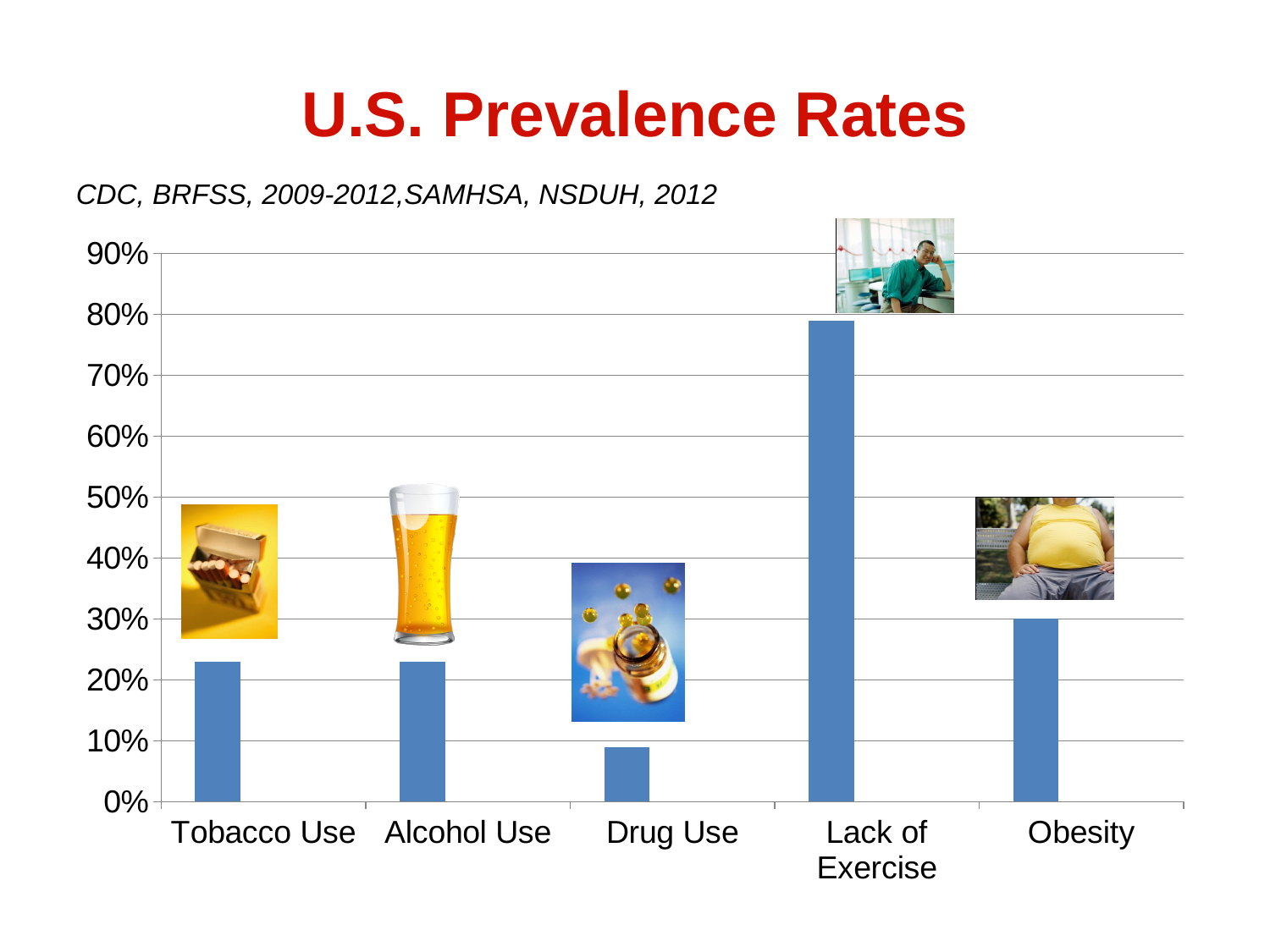
Which category has the highest prevalence rate? Lack of Exercise What is the prevalence rate for Obesity? 30% What is the title of the chart? U.S. Prevalence Rates Which category has the lowest prevalence rate? Drug Use Is the value for Alcohol Use greater or less than 30%? less Is the value for Lack of Exercise greater or less than 70%? greater What kind of chart is shown on the slide? bar chart What data sources are cited below the chart title? CDC, BRFSS, 2009-2012,SAMHSA, NSDUH, 2012 Is the value for Tobacco Use greater or less than 20%? greater How many categories are shown on the x axis of the chart? 5 Which is larger, the value for Obesity or the value for Tobacco Use? Obesity